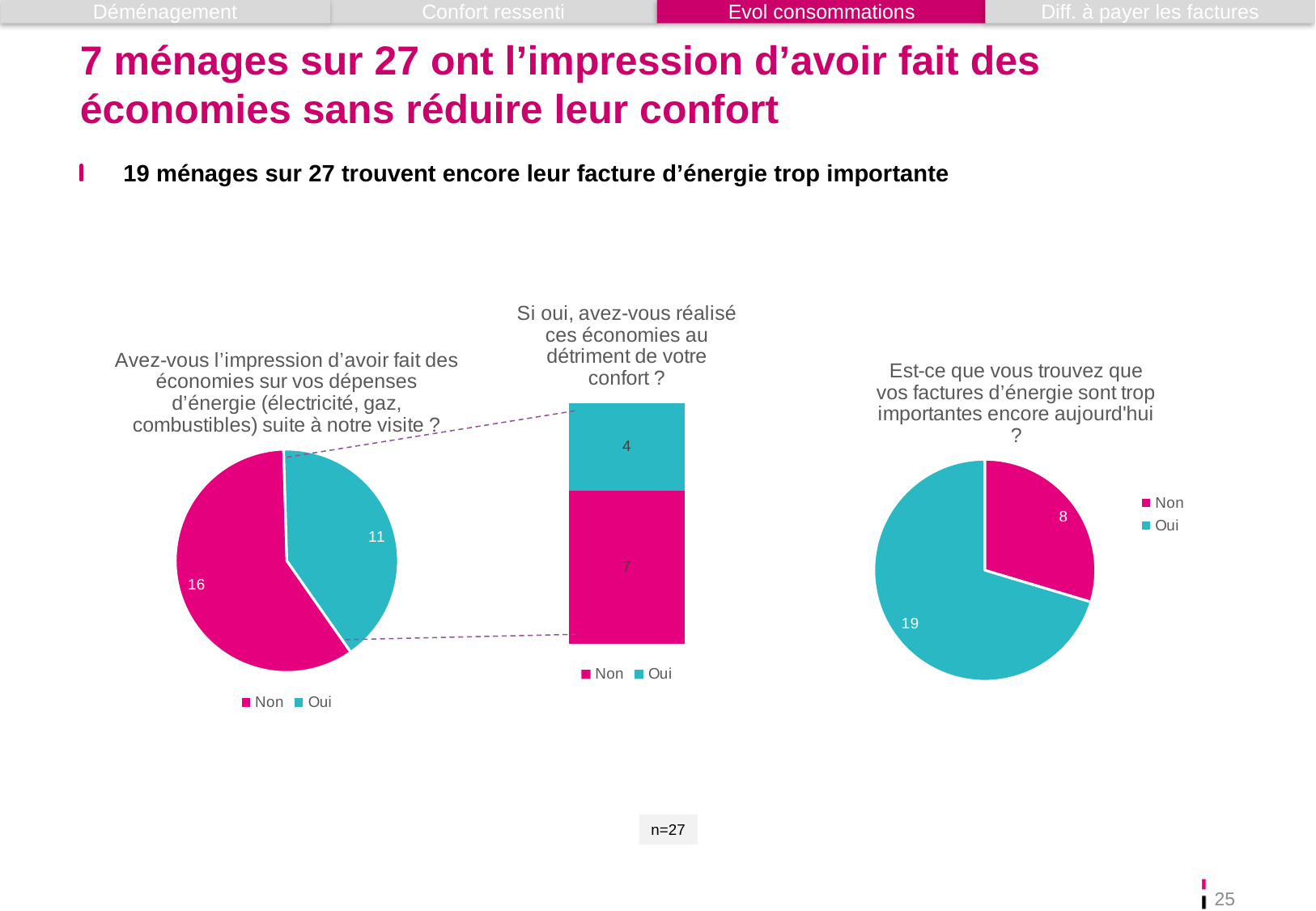
In the left pie chart 'Avez-vous l'impression d'avoir fait des économies...', what is the value for Oui? 11 What type of chart is the chart on the right of the slide? Pie chart In the stacked bar 'Si oui, avez-vous réalisé ces économies au détriment de votre confort ?', what is the total of the bar? 11 In the left pie chart 'Avez-vous l'impression d'avoir fait des économies...', what is the difference between Non and Oui? 5 In the right pie chart 'Est-ce que vous trouvez que vos factures d'énergie sont trop importantes encore aujourd'hui ?', how many categories does the legend list? 2 In the right pie chart 'Est-ce que vous trouvez que vos factures d'énergie sont trop importantes encore aujourd'hui ?', what is the value for Oui? 19 In the left pie chart 'Avez-vous l'impression d'avoir fait des économies...', what is the value for Non? 16 In the right pie chart 'Est-ce que vous trouvez que vos factures d'énergie sont trop importantes encore aujourd'hui ?', which category is the smallest? Non In the stacked bar 'Si oui, avez-vous réalisé ces économies au détriment de votre confort ?', what is the value for Non? 7 In the stacked bar 'Si oui, avez-vous réalisé ces économies au détriment de votre confort ?', what is the value for Oui? 4 In the left pie chart 'Avez-vous l'impression d'avoir fait des économies...', which category has the larger value? Non In the right pie chart 'Est-ce que vous trouvez que vos factures d'énergie sont trop importantes encore aujourd'hui ?', what is the value for Non? 8